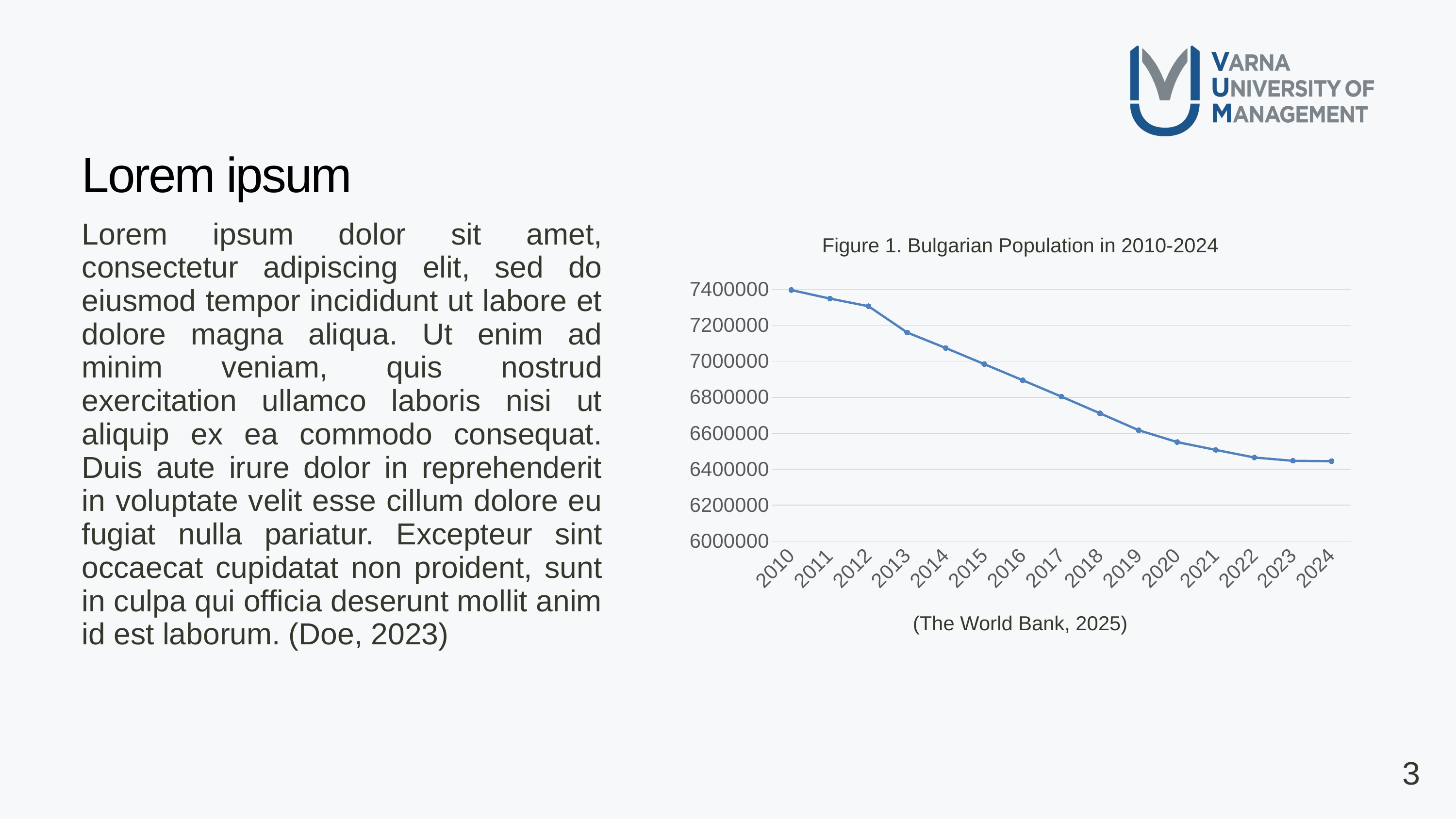
Is the value for 2011 greater or less than 7200000? greater Is the value for 2013 greater or less than 7200000? less Which year has the larger value, 2012 or 2018? 2012 How many years are plotted on the x axis of the chart? 15 Which year has the highest value in the chart? 2010 Is the value for 2014 greater or less than 7000000? greater What kind of chart is shown on the slide? line chart Do the values in the chart rise or fall from 2010 to 2024? fall What is the title of the chart? Figure 1. Bulgarian Population in 2010-2024